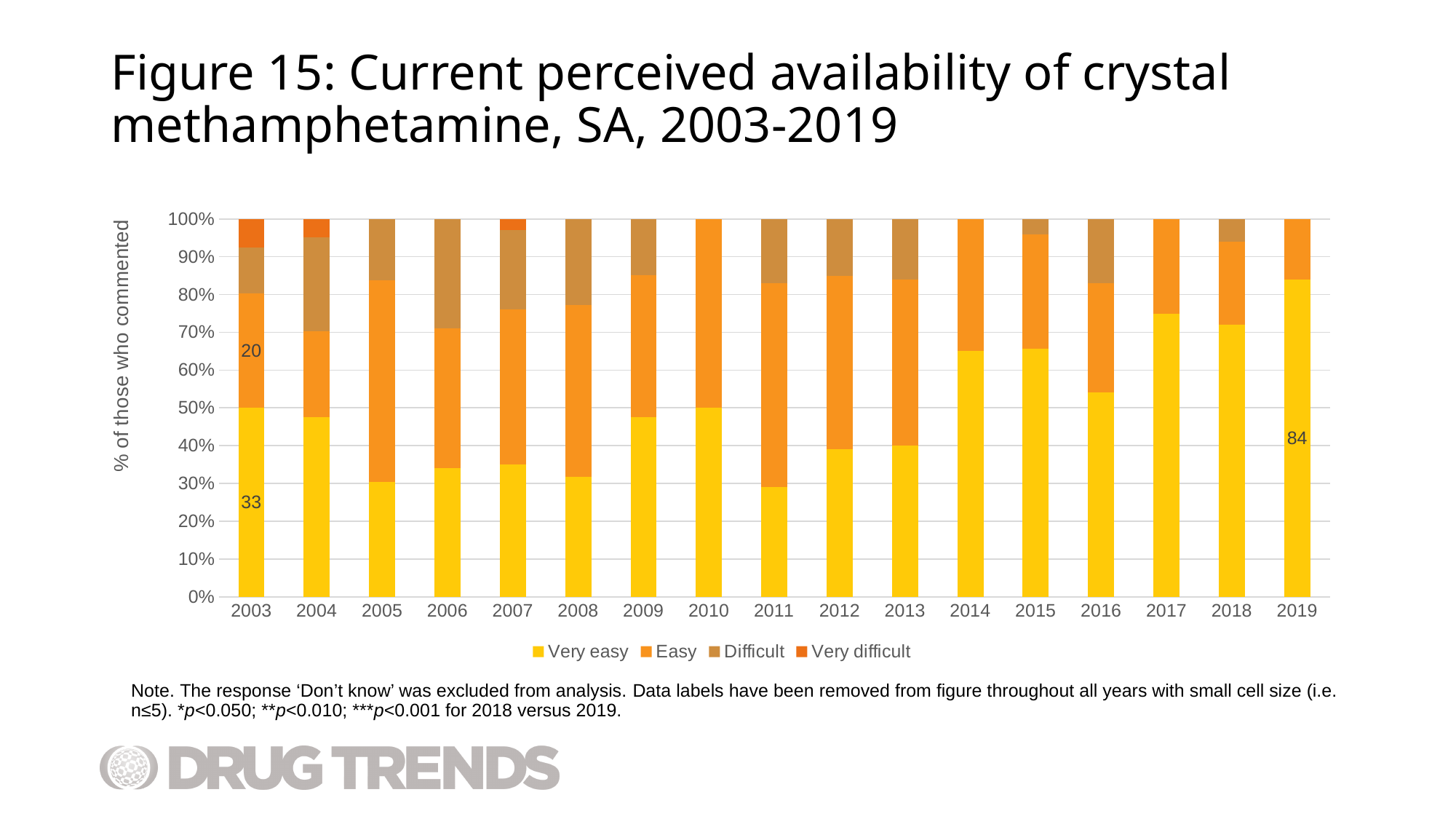
What kind of chart is shown on the slide? Stacked bar chart Which has the larger Very easy share, 2017 or 2012? 2017 What data label is printed on the Very easy segment for 2019? 84 Is the Very easy share for 2019 greater or less than 80%? greater What is the title of the y axis? % of those who commented How many years are shown along the x axis? 17 Is the Very easy share for 2006 greater or less than 40%? less How many series does the legend list? 4 Is the Very easy share for 2014 greater or less than 60%? greater Which year has the largest Very easy share? 2019 What data label is printed on the Very easy segment for 2003? 33 What data label is printed on the Easy segment for 2003? 20